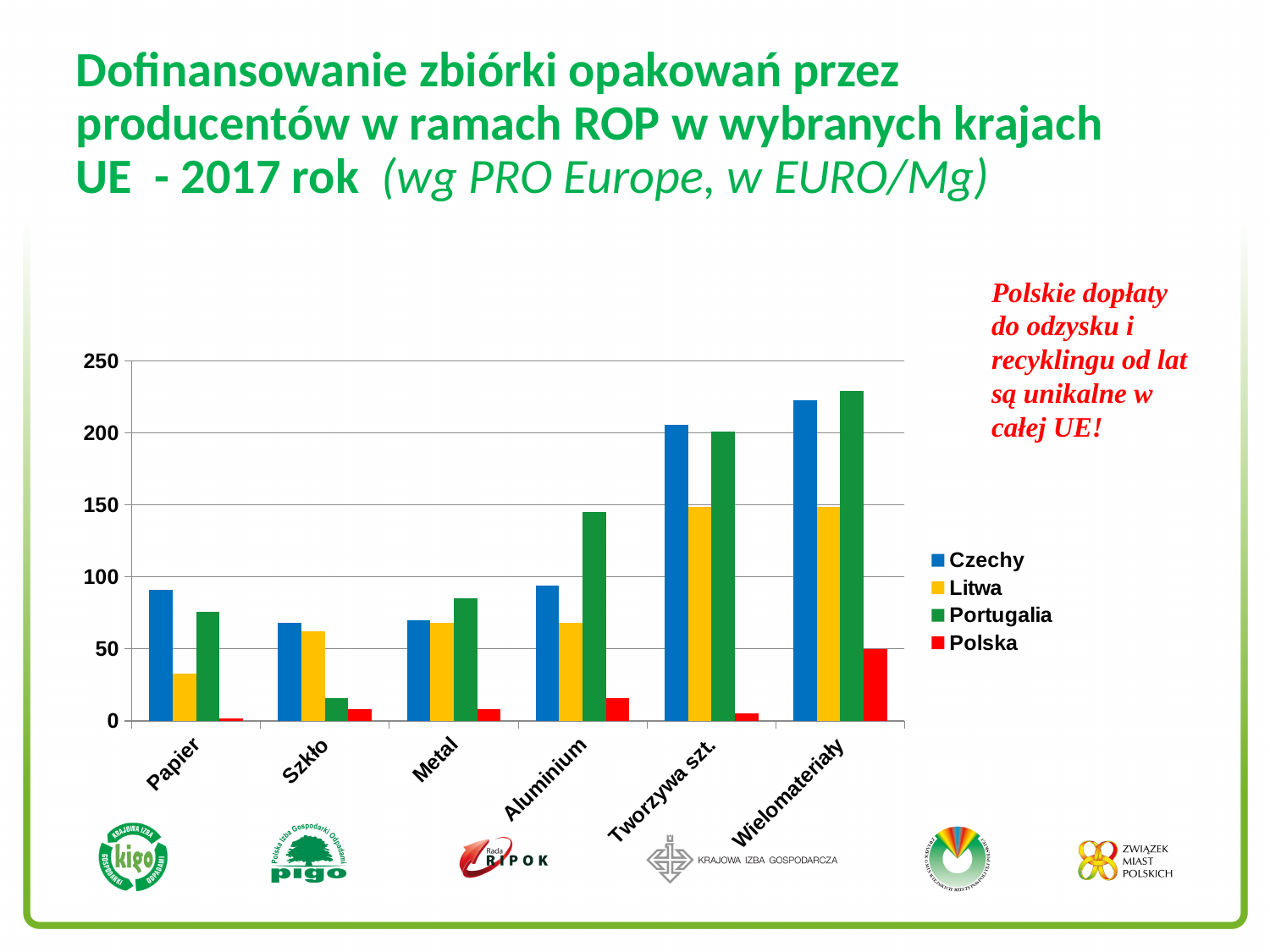
Is the value for Litwa in the Papier category greater or less than 50? less How many categories are shown on the x axis of the chart? 6 Is the value for Polska in the Wielomateriały category greater or less than 100? less Is the value for Portugalia in the Aluminium category greater or less than 100? greater In the Szkło category, which is larger: the value for Czechy or the value for Portugalia? Czechy How many series does the chart legend list? 4 In the Tworzywa szt. category, which is larger: the value for Litwa or the value for Polska? Litwa Which country has the lowest value in the Papier category? Polska Which countries are listed in the chart legend? Czechy, Litwa, Portugalia, Polska Which country has the highest value in the Aluminium category? Portugalia What kind of chart is shown on the slide? bar chart